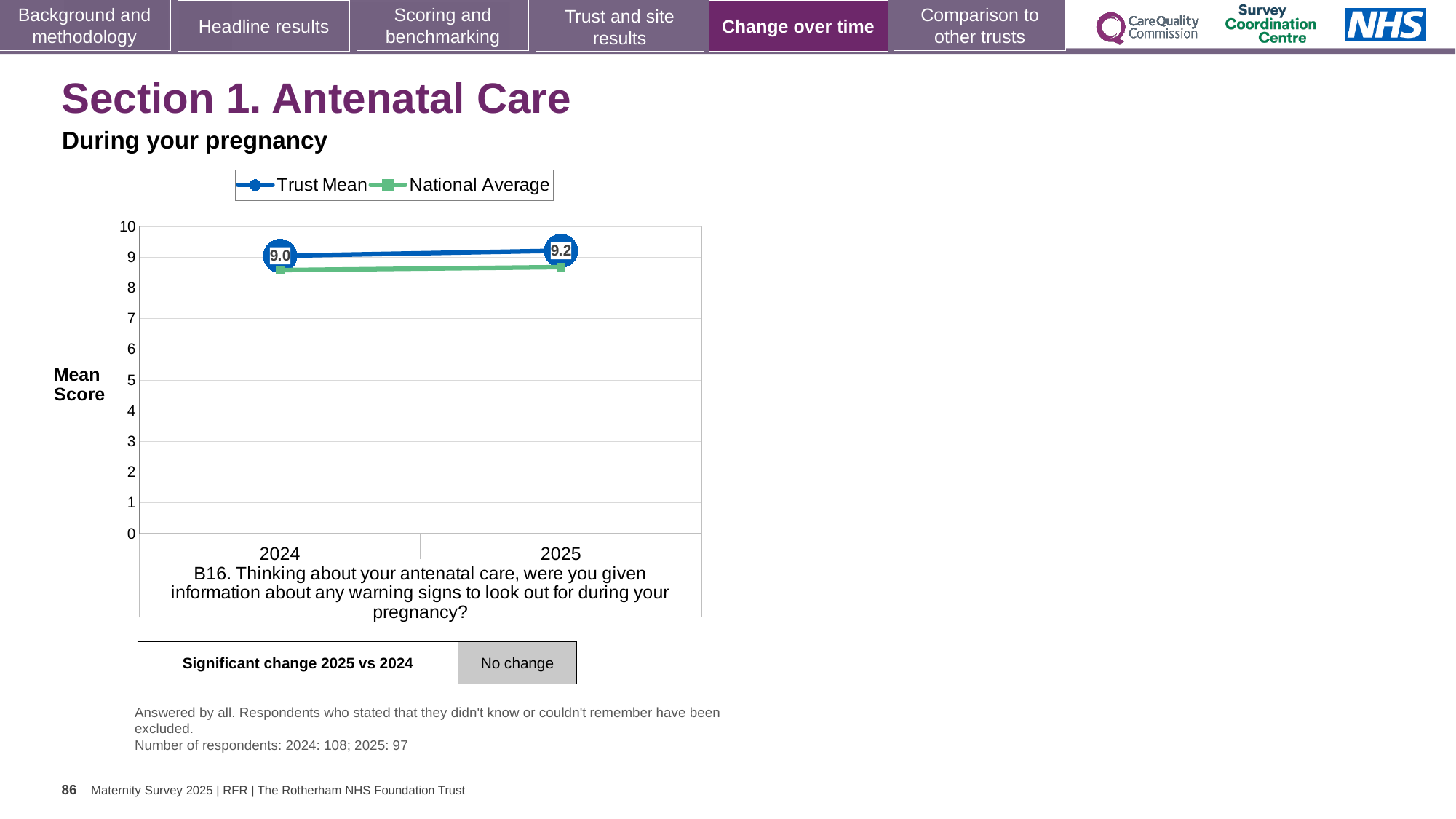
What is the label on the y axis of the chart? Mean Score By how much did the Trust Mean change from 2024 to 2025? 0.2 Is the National Average for 2024 greater or less than 8? greater What is the Trust Mean score for 2025? 9.2 How many years are shown on the x axis? 2 In 2025, which is higher, the Trust Mean or the National Average? Trust Mean Does the Trust Mean rise or fall from 2024 to 2025? rise How many series does the legend list? 2 What kind of chart is shown on the slide? line chart What is the Trust Mean score for 2024? 9.0 Which year has the higher Trust Mean score, 2024 or 2025? 2025 Is the National Average for 2025 greater or less than 9? less